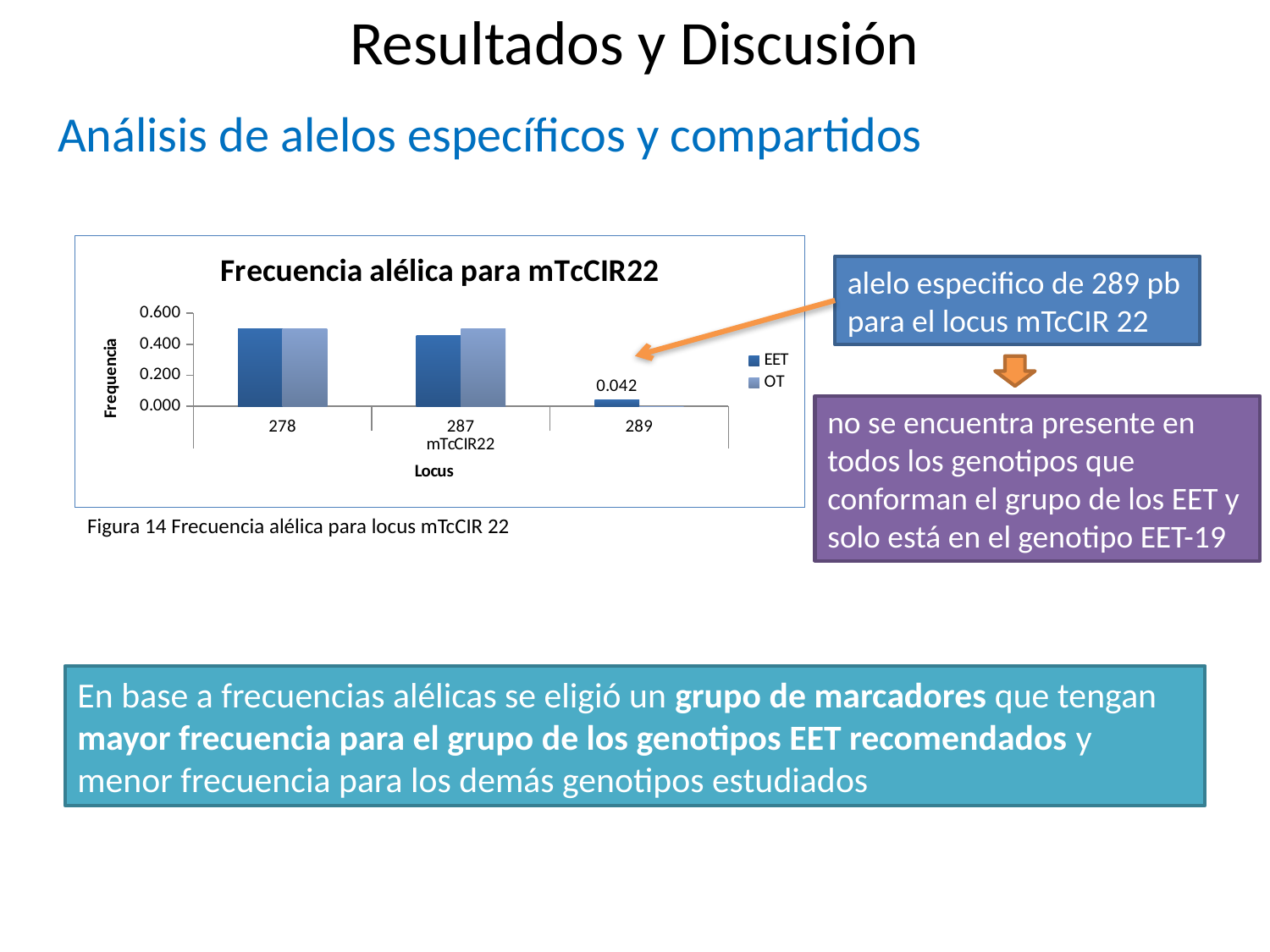
Is the OT value for allele 287 greater or less than 0.400? greater What is the title of the chart? Frecuencia alélica para mTcCIR22 What kind of chart is shown on the slide? Bar chart Which is larger: the EET value for allele 278 or the EET value for allele 289? 278 Is the EET value for allele 278 greater or less than 0.400? greater Is the EET value for allele 289 greater or less than 0.200? less How many series does the chart legend list? 2 How many allele categories are shown on the x axis of the chart? 3 What is the value of the EET series for allele 289 in the chart 'Frecuencia alélica para mTcCIR22'? 0.042 What are the two series named in the chart legend? EET and OT Which is larger for allele 287: the EET value or the OT value? OT Which allele has the lowest EET frequency in the chart? 289